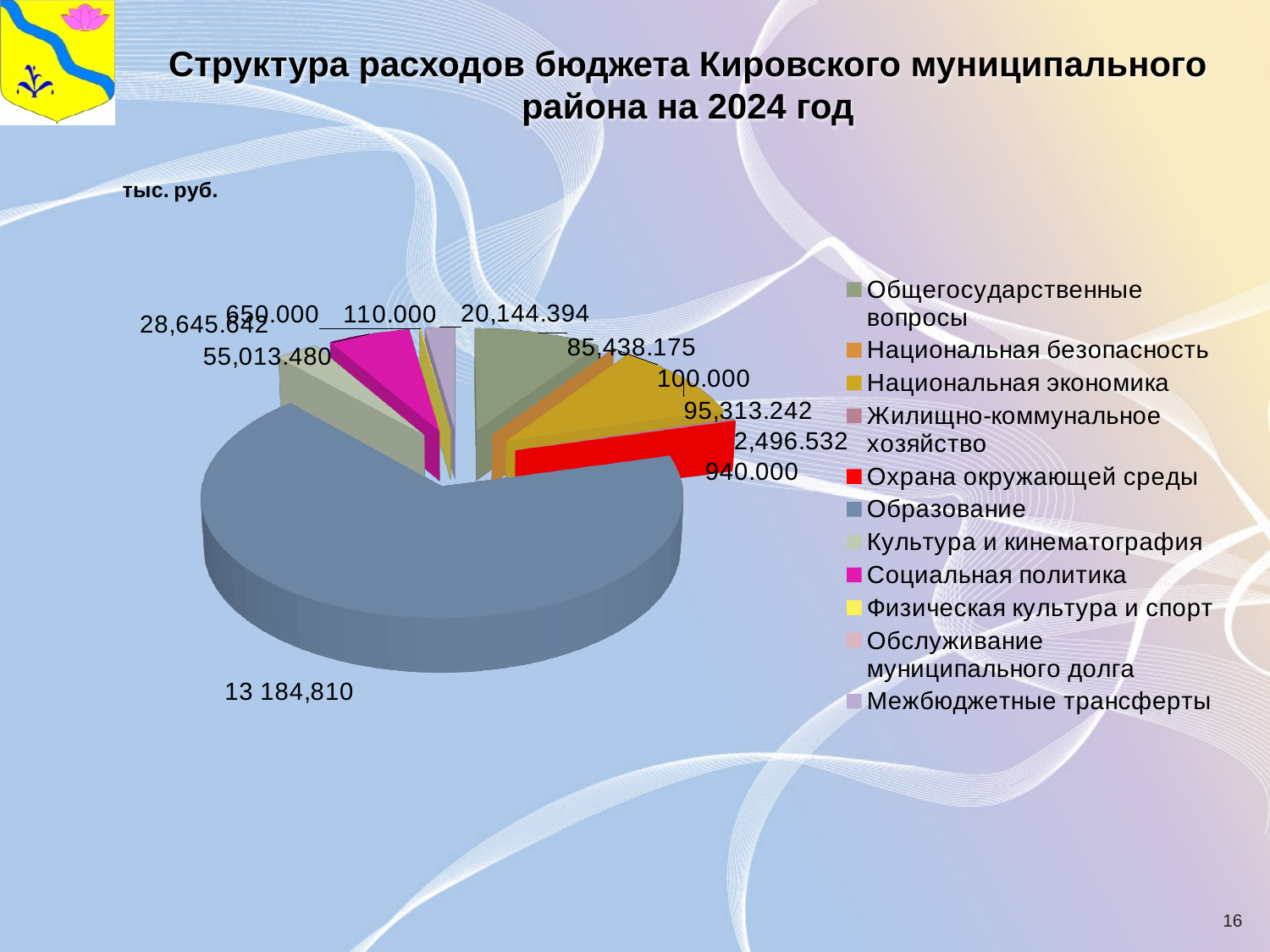
What colour is the Охрана окружающей среды slice in the pie chart? red In what units are the values of the chart given, according to the label above it? тыс. руб. Which is larger, the slice for Образование or the slice for Социальная политика? Образование Which is larger, the slice for Образование or the slice for Общегосударственные вопросы? Образование Which category has the largest slice in the pie chart? Образование How many categories does the legend of the pie chart list? 11 What kind of chart is shown on the slide? pie chart What value is labelled for the Образование slice? 13 184,810